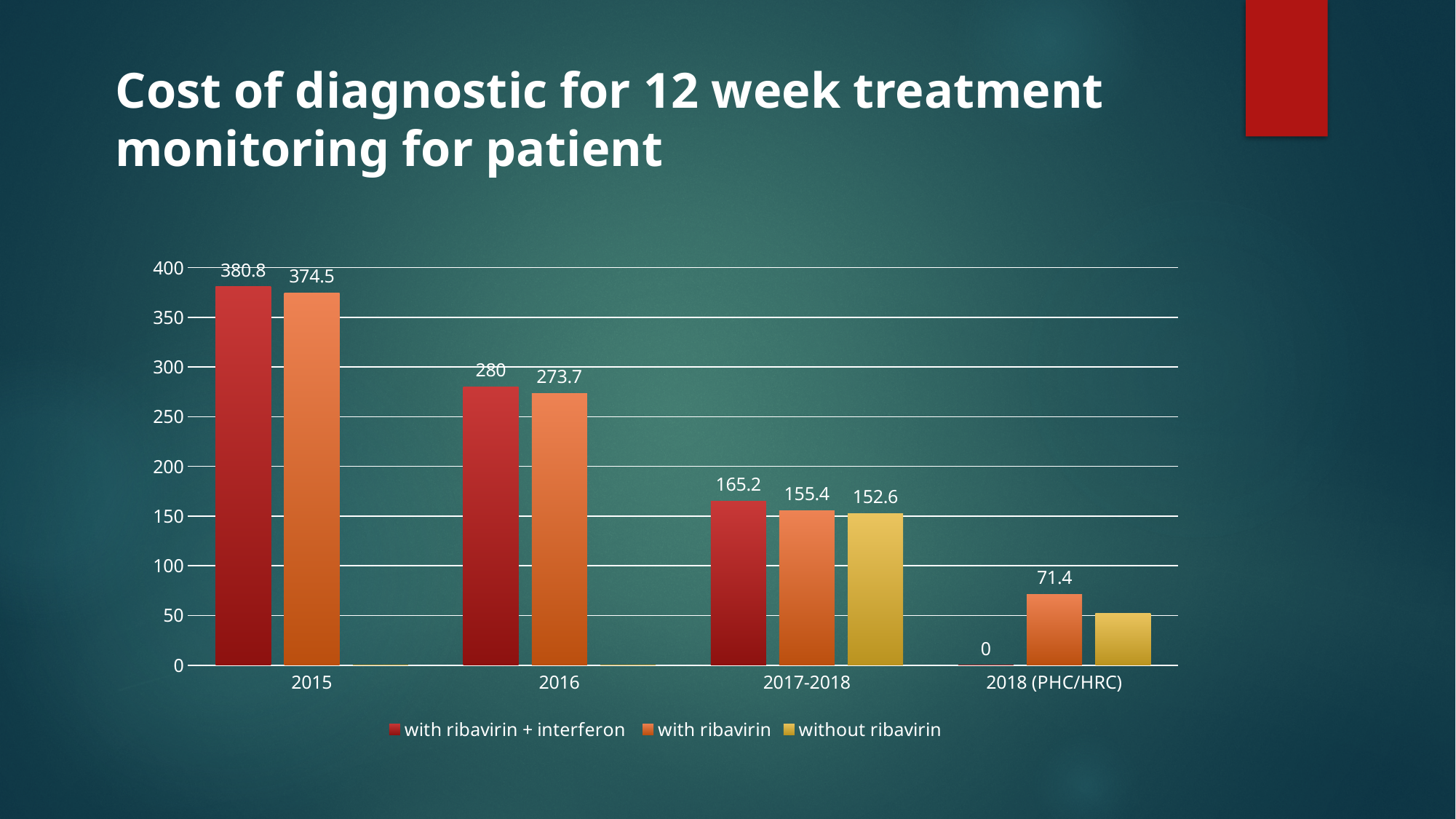
What is the difference between 'with ribavirin + interferon' and 'with ribavirin' in 2016? 6.3 What is the value for 'with ribavirin' in 2018 (PHC/HRC)? 71.4 What is the value for 'with ribavirin' in 2016? 273.7 Does the value for 'with ribavirin' rise or fall from 2015 to 2018 (PHC/HRC)? fall How many series does the legend list? 3 Is the value for 'without ribavirin' in 2018 (PHC/HRC) greater or less than 100? less Which category has the lowest value for 'with ribavirin'? 2018 (PHC/HRC) What is the value for 'without ribavirin' in 2017-2018? 152.6 Which year has the highest value for 'with ribavirin + interferon'? 2015 What is the value for 'with ribavirin + interferon' in 2015? 380.8 Which is larger in 2017-2018: 'with ribavirin' or 'without ribavirin'? with ribavirin How many categories are shown on the x axis? 4